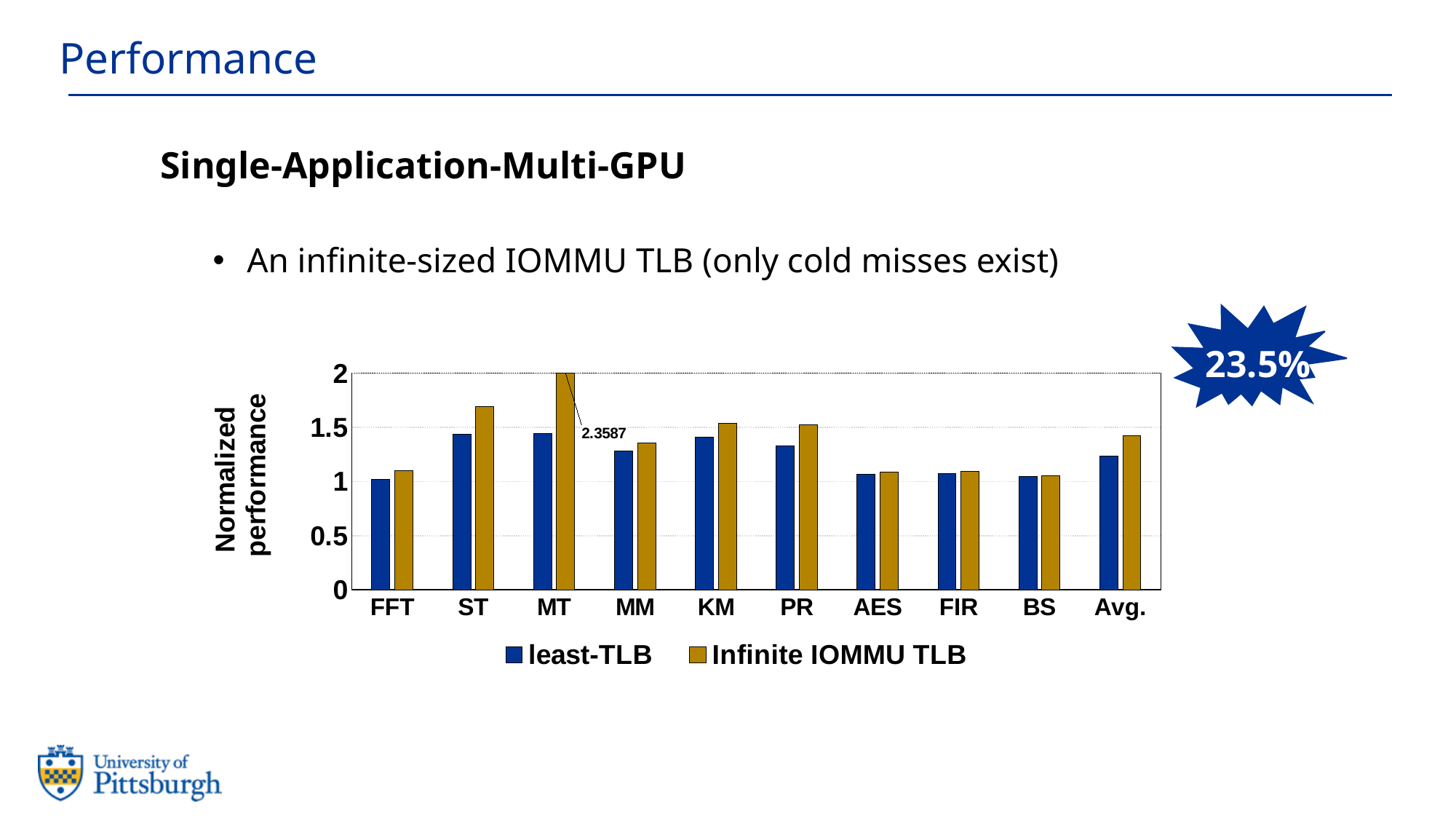
Which category has the highest Infinite IOMMU TLB bar? MT Is the Infinite IOMMU TLB value for ST greater or less than 1.5? greater Is the least-TLB value for FFT greater or less than 1.5? less Is the least-TLB value for Avg. greater or less than 1? greater What are the two series named in the chart's legend? least-TLB and Infinite IOMMU TLB How many series does the chart's legend list? 2 What kind of chart is shown on the slide? bar chart What is the Infinite IOMMU TLB value for MT? 2.3587 What is the label on the y axis of the chart? Normalized performance How many categories are shown on the x axis of the chart? 10 For ST, which series has the larger value, least-TLB or Infinite IOMMU TLB? Infinite IOMMU TLB